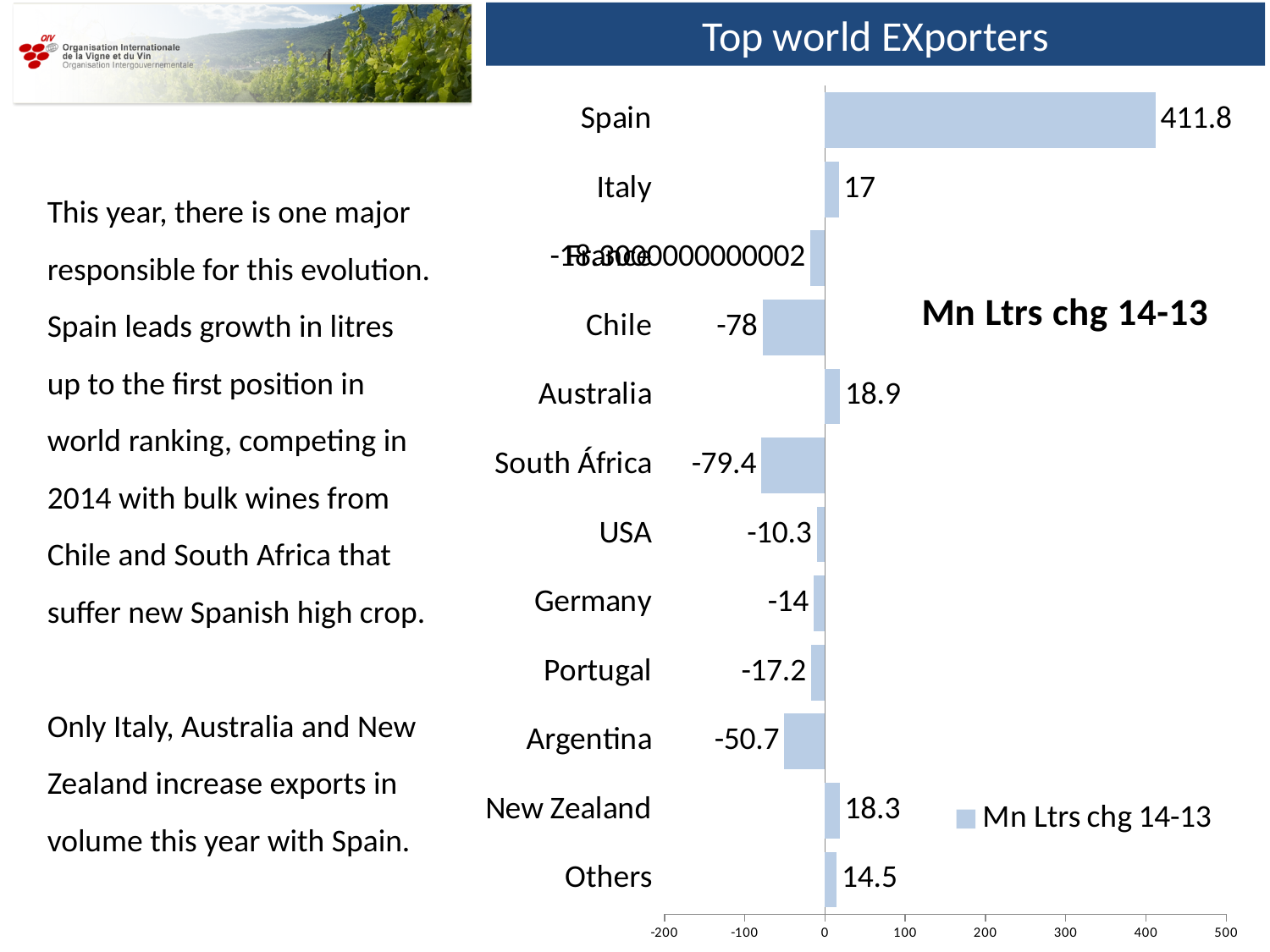
What is the value for Chile? -78 How many categories are shown on the chart? 12 What is the value for Spain? 411.8 What kind of chart is shown on the slide? Bar chart What is the name of the series shown in the legend? Mn Ltrs chg 14-13 What is the difference between the values for Australia and Italy? 1.9 Which category has the lowest value? South África What is the value for New Zealand? 18.3 Which category has the highest value? Spain Which is larger, the value for Portugal or the value for Germany? Germany What is the value for South África? -79.4 What is the value for Argentina? -50.7